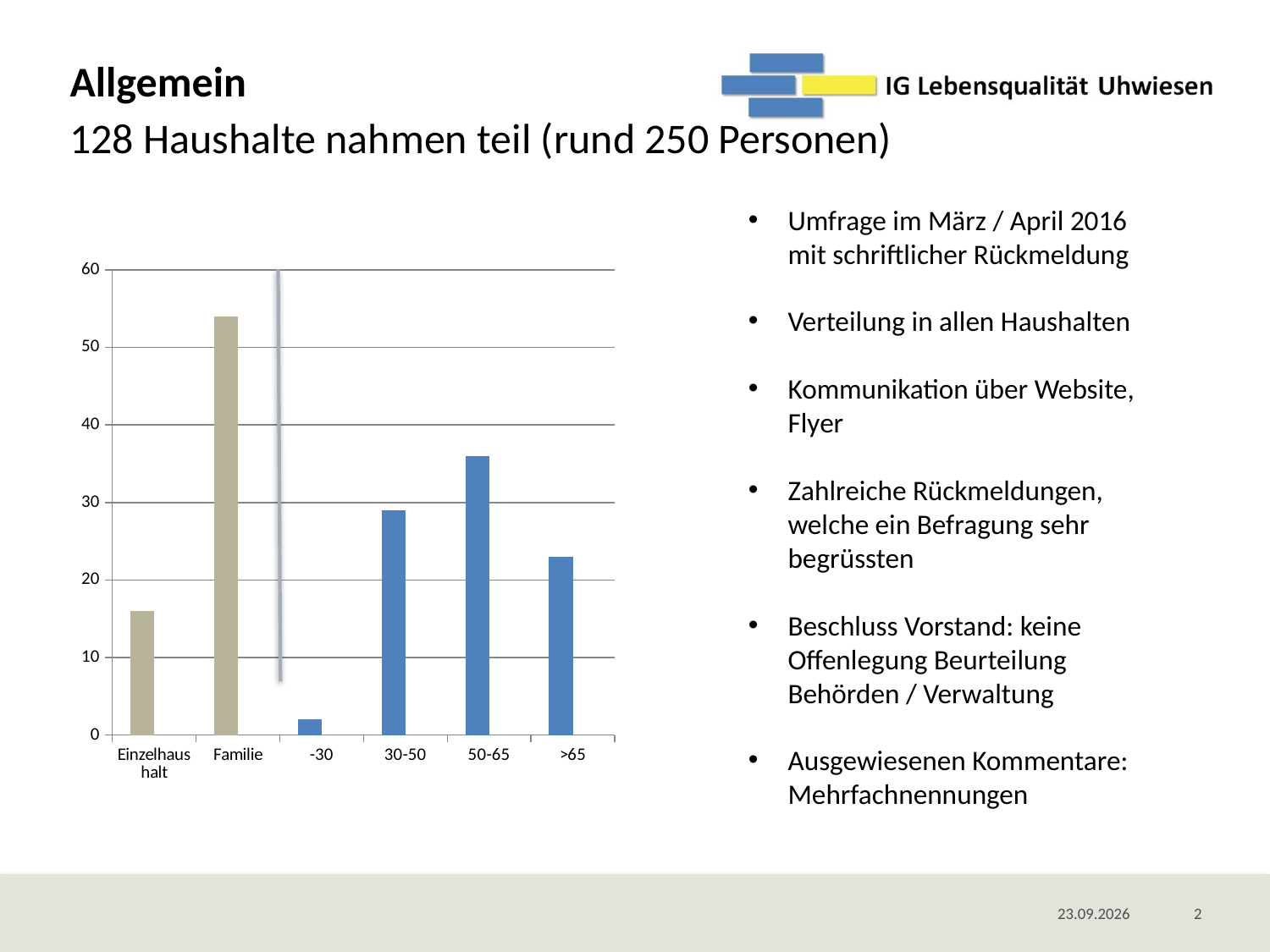
Which is larger, the value for 50-65 or the value for 30-50? 50-65 Which category has the lowest bar in the chart? -30 Is the value for 50-65 greater or less than 30? greater Is the value for Einzelhaushalt greater or less than 20? less What colour are the bars for the age-group categories (-30, 30-50, 50-65, >65)? blue Which is larger, the value for Einzelhaushalt or the value for >65? >65 What kind of chart is shown on the slide? bar chart Is the value for >65 greater or less than 30? less How many categories are shown on the x axis of the chart? 6 Which category has the highest bar in the chart? Familie